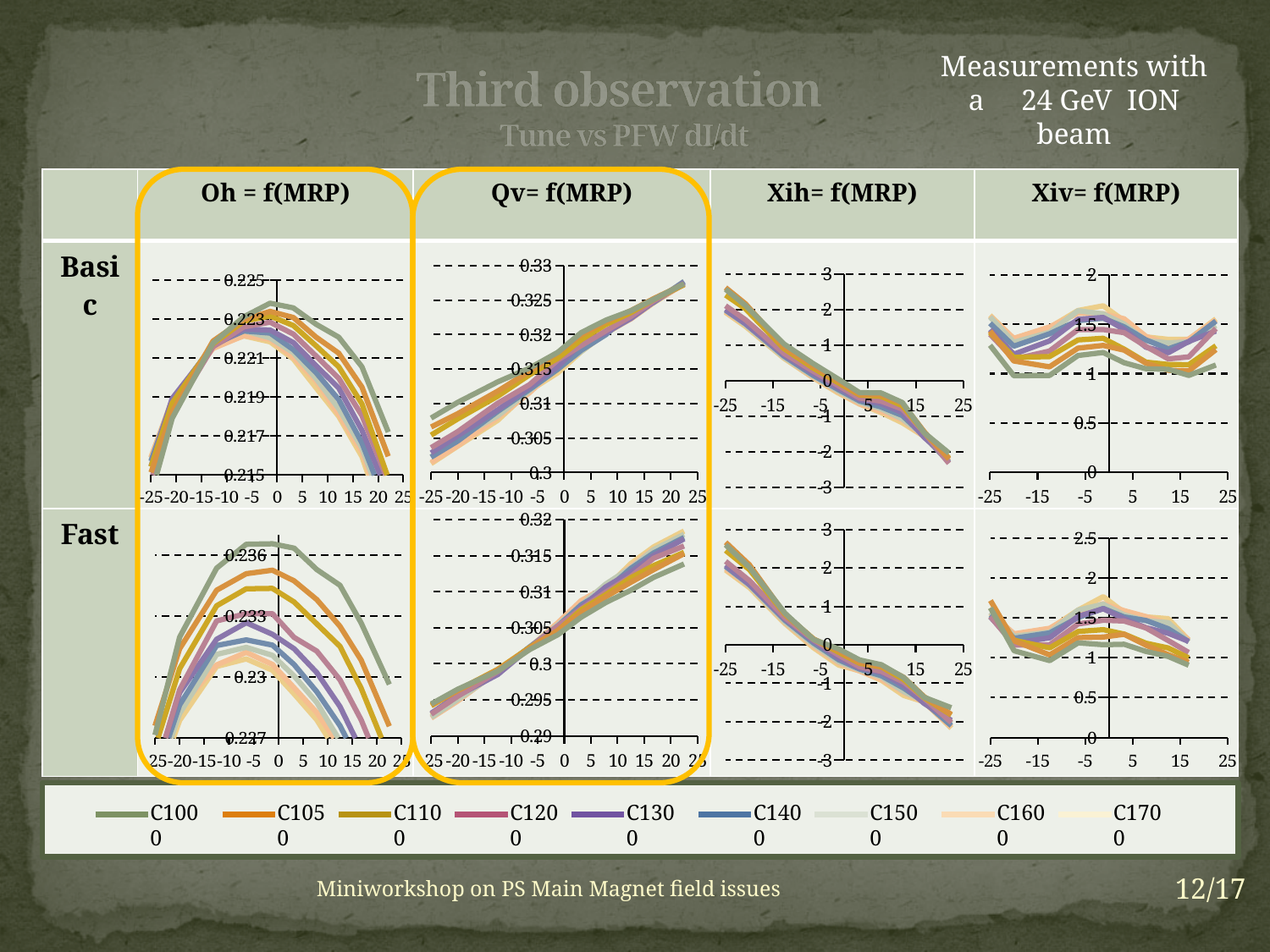
In the Fast Qv= f(MRP) chart, are the values at x = -25 greater or less than 0.305? less In the Fast Xih= f(MRP) chart, do the values rise or fall as x increases from -25 to 25? fall What kind of chart is the Basic Oh = f(MRP) chart? line chart In the Basic Xiv= f(MRP) chart, are the values at x = -25 greater or less than 1? greater In the Basic Xih= f(MRP) chart, are the values at x = -25 greater or less than 1? greater What is the lowest y-axis tick shown on the Basic Oh = f(MRP) chart? 0.215 In the Basic Qv= f(MRP) chart, do the values rise or fall as x increases from -25 to 25? rise How many charts are shown on the slide? 8 What is the highest y-axis tick shown on the Fast Xiv= f(MRP) chart? 2.5 How many series does the legend at the bottom of the slide list? 9